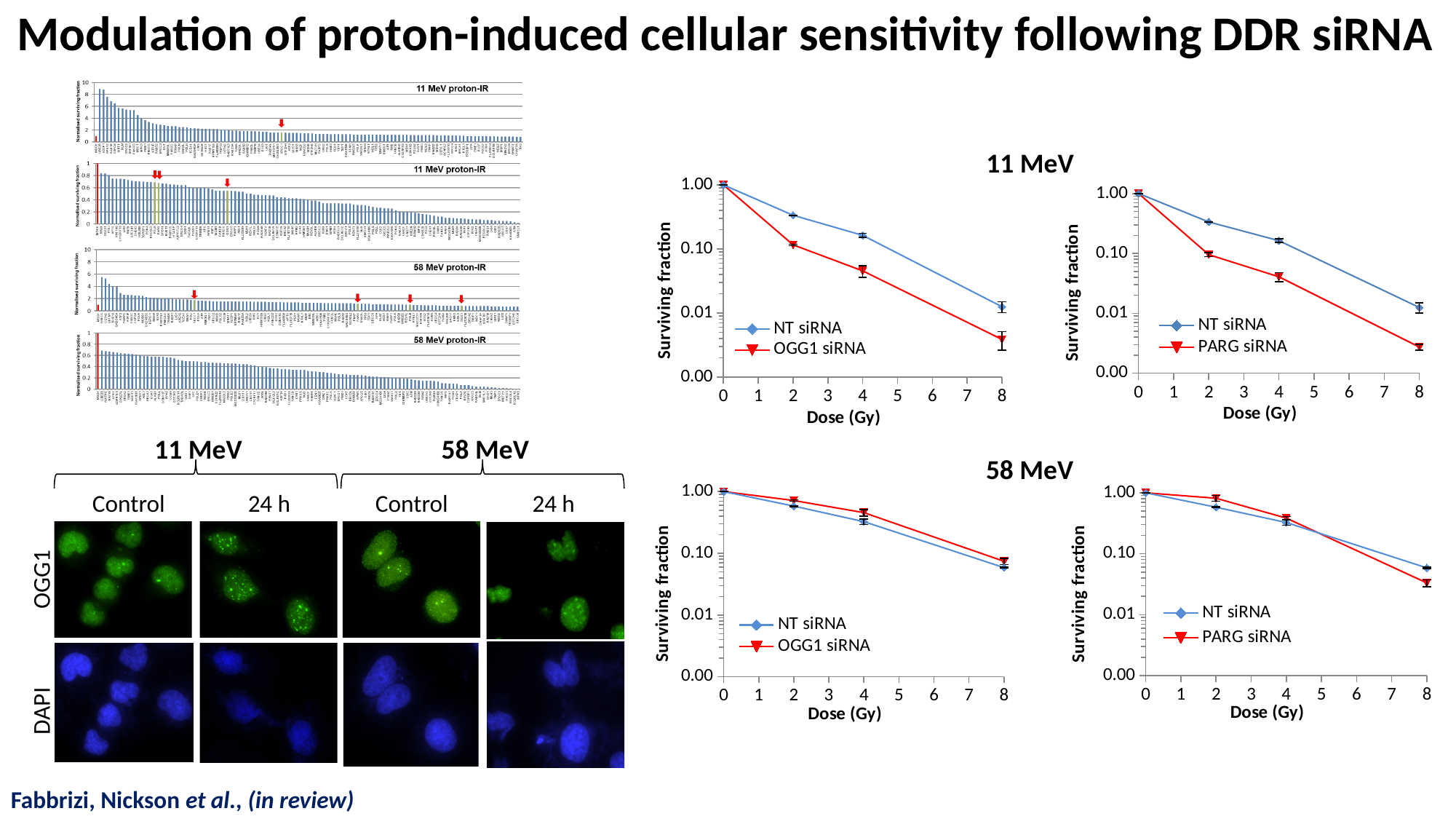
In the top-left line chart under the 11 MeV heading (NT siRNA vs OGG1 siRNA), is the surviving fraction for OGG1 siRNA at 8 Gy greater or less than 0.01? less In the top-right line chart under the 11 MeV heading (NT siRNA vs PARG siRNA), does the surviving fraction for NT siRNA rise or fall as dose increases? fall In the bottom-right line chart under the 58 MeV heading (NT siRNA vs PARG siRNA), what is the x-axis label? Dose (Gy) In the top-right line chart under the 11 MeV heading (NT siRNA vs PARG siRNA), what are the two legend entries? NT siRNA and PARG siRNA In the top-left line chart under the 11 MeV heading (NT siRNA vs OGG1 siRNA), which series has the larger surviving fraction at 4 Gy, NT siRNA or OGG1 siRNA? NT siRNA In the bottom-right line chart under the 58 MeV heading (NT siRNA vs PARG siRNA), which series has the larger surviving fraction at 8 Gy, NT siRNA or PARG siRNA? NT siRNA In the top-left line chart under the 11 MeV heading (NT siRNA vs OGG1 siRNA), what kind of chart is shown? line chart In the bottom-left line chart under the 58 MeV heading (NT siRNA vs OGG1 siRNA), is the surviving fraction for NT siRNA at 8 Gy greater or less than 0.10? less In the top-left line chart under the 11 MeV heading (NT siRNA vs OGG1 siRNA), what is the surviving fraction for NT siRNA at a dose of 0 Gy? 1.00 In the bottom-left line chart under the 58 MeV heading (NT siRNA vs OGG1 siRNA), how many dose points are plotted for each series? 4 In the top-right line chart under the 11 MeV heading (NT siRNA vs PARG siRNA), is the surviving fraction for PARG siRNA at 4 Gy greater or less than 0.10? less In the top-left line chart under the 11 MeV heading (NT siRNA vs OGG1 siRNA), how many series does the legend list? 2